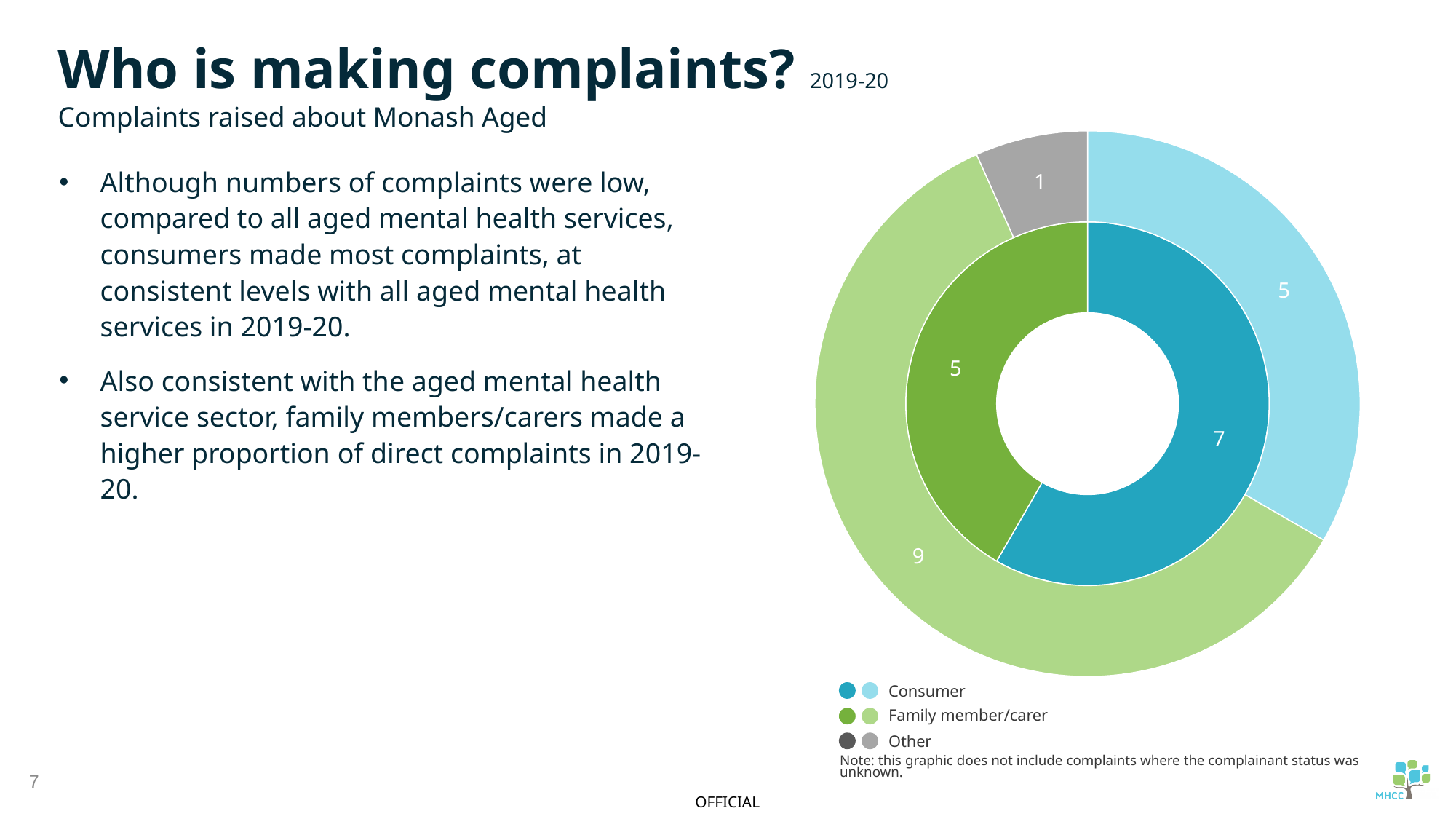
What is the total of the values shown in the outer ring of the doughnut chart? 15 In the inner ring, which is larger: Consumer or Family member/carer? Consumer Which category has the largest value in the outer ring of the doughnut chart? Family member/carer In the inner ring of the doughnut chart, what is the value for Consumer? 7 Which category has the smallest value in the outer ring of the doughnut chart? Other In the outer ring of the doughnut chart, what is the value for Family member/carer? 9 In the outer ring, what is the difference between the Family member/carer value and the Consumer value? 4 In the outer ring of the doughnut chart, what is the value for Other? 1 What kind of chart is shown on the slide? Doughnut chart How many categories does the chart legend list? 3 In the inner ring of the doughnut chart, what is the value for Family member/carer? 5 In the outer ring of the doughnut chart, what is the value for Consumer? 5